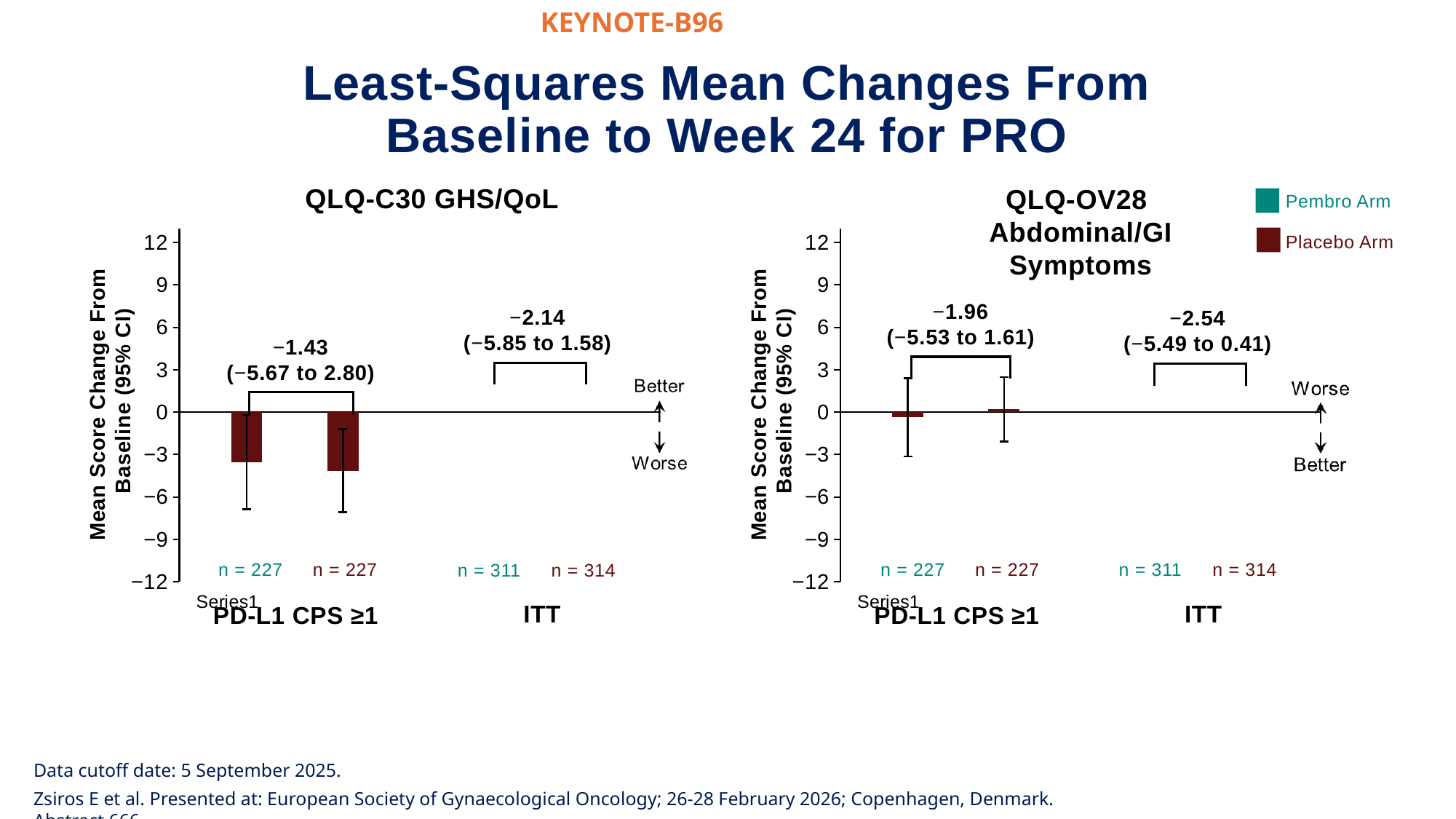
In the QLQ-C30 GHS/QoL chart, what is the 95% CI shown for the ITT difference of −2.14? −5.85 to 1.58 How many population categories are shown on the x axis of the QLQ-C30 GHS/QoL chart? 2 In the QLQ-OV28 Abdominal/GI Symptoms chart, what is the 95% CI shown for the PD-L1 CPS ≥1 difference? −5.53 to 1.61 In the QLQ-C30 GHS/QoL chart, is the mean score change for the Placebo Arm in the PD-L1 CPS ≥1 population greater or less than 0? less In the QLQ-OV28 Abdominal/GI Symptoms chart, what is the n for the Pembro Arm in the PD-L1 CPS ≥1 population? n = 227 In the QLQ-C30 GHS/QoL chart, what is the n for the Placebo Arm in the ITT population? n = 314 How many series does the legend list? 2 What kind of chart is the QLQ-C30 GHS/QoL chart? Bar chart What is the y-axis label on the QLQ-C30 GHS/QoL chart? Mean Score Change From Baseline (95% CI) In the QLQ-C30 GHS/QoL chart, what is the between-arm difference shown for the PD-L1 CPS ≥1 population? −1.43 In the QLQ-OV28 Abdominal/GI Symptoms chart, what is the between-arm difference shown for the ITT population? −2.54 Which chart shows the larger (more negative) ITT between-arm difference, QLQ-C30 GHS/QoL (−2.14) or QLQ-OV28 Abdominal/GI Symptoms (−2.54)? QLQ-OV28 Abdominal/GI Symptoms